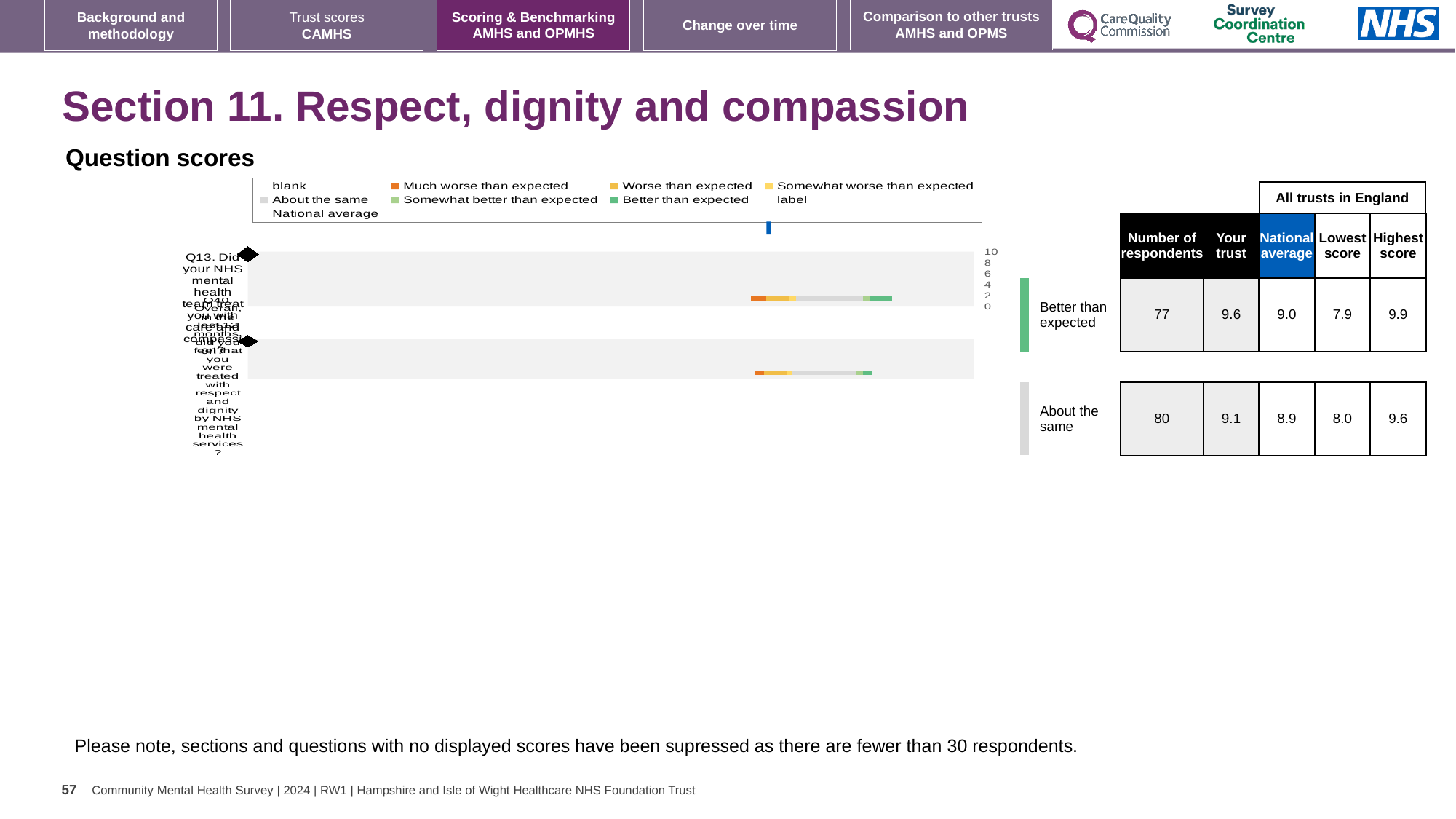
For the row rated 'About the same', what is the difference between the highest score and the lowest score? 1.6 How many question rows are plotted in the chart? 2 In the table next to the chart, how many respondents are shown for the row rated 'Better than expected'? 77 What is the 'Your trust' score for the row rated 'Better than expected'? 9.6 What is the heading printed above the chart? Question scores Which row has the higher 'Highest score' value? Better than expected What is the lowest score across all trusts in England for the row rated 'Better than expected'? 7.9 What is the national average for the row rated 'About the same'? 8.9 What kind of chart is used to show the question scores? Bar chart What is the highest score across all trusts in England for the row rated 'About the same'? 9.6 For the row rated 'Better than expected', how much higher is the 'Your trust' score than the national average? 0.6 Which row has more respondents, 'Better than expected' or 'About the same'? About the same